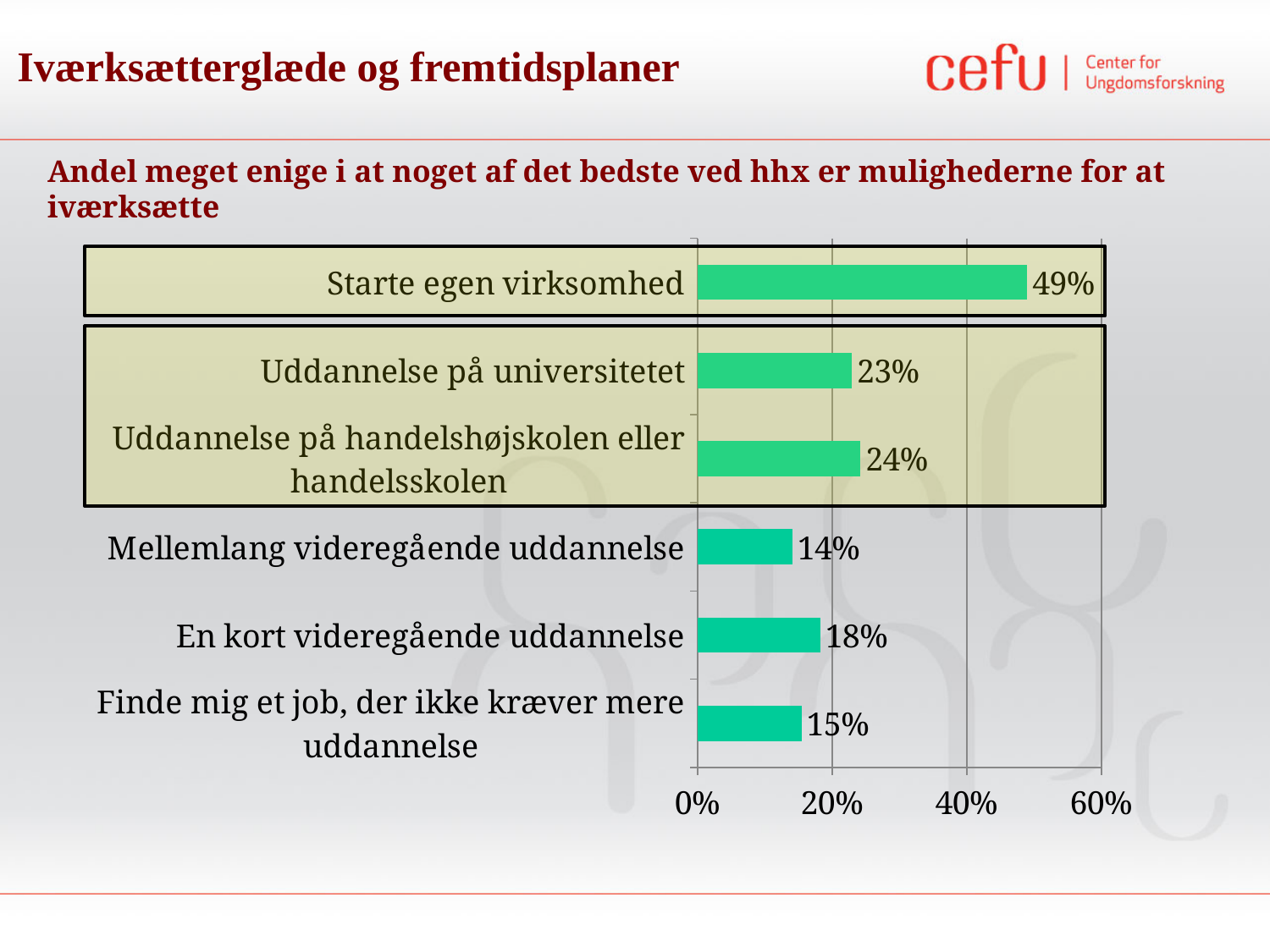
Which is larger: the value for "En kort videregående uddannelse" or the value for "Mellemlang videregående uddannelse"? En kort videregående uddannelse What is the value for "Finde mig et job, der ikke kræver mere uddannelse"? 15% What is the value for "Uddannelse på universitetet"? 23% What is the value for "Starte egen virksomhed"? 49% What is the difference between the values for "Starte egen virksomhed" and "Uddannelse på handelshøjskolen eller handelsskolen"? 25% What kind of chart is shown on the slide? bar chart Which category has the lowest value? Mellemlang videregående uddannelse How many categories are shown in the chart? 6 What is the highest value shown on the x axis? 60% What is the value for "Mellemlang videregående uddannelse"? 14% Which category has the highest value? Starte egen virksomhed Is the value for "Starte egen virksomhed" greater or less than 40%? greater